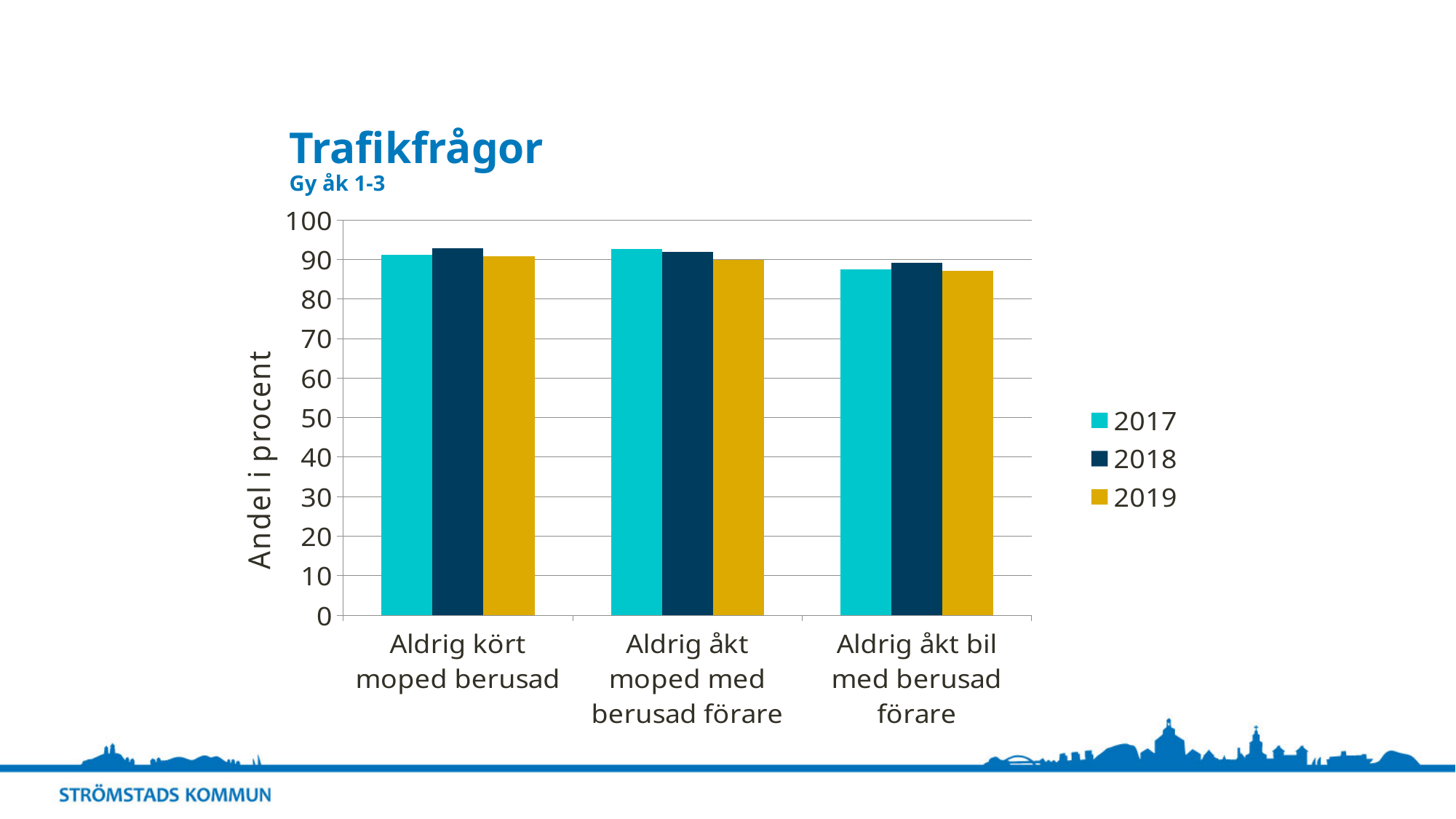
Is the 2019 value for 'Aldrig åkt bil med berusad förare' greater or less than 80? greater Which category has the lowest 2019 value? Aldrig åkt bil med berusad förare Which years are listed in the chart's legend? 2017, 2018, 2019 For 2017, which is larger: the value for 'Aldrig åkt moped med berusad förare' or for 'Aldrig åkt bil med berusad förare'? Aldrig åkt moped med berusad förare How many series does the legend list? 3 Is the 2017 value for 'Aldrig åkt bil med berusad förare' greater or less than 90? less What kind of chart is shown on the slide? bar chart Which category has the lowest 2018 value? Aldrig åkt bil med berusad förare What is the label of the vertical axis? Andel i procent How many categories are shown on the x axis of the chart? 3 Is the 2018 value for 'Aldrig kört moped berusad' greater or less than 90? greater